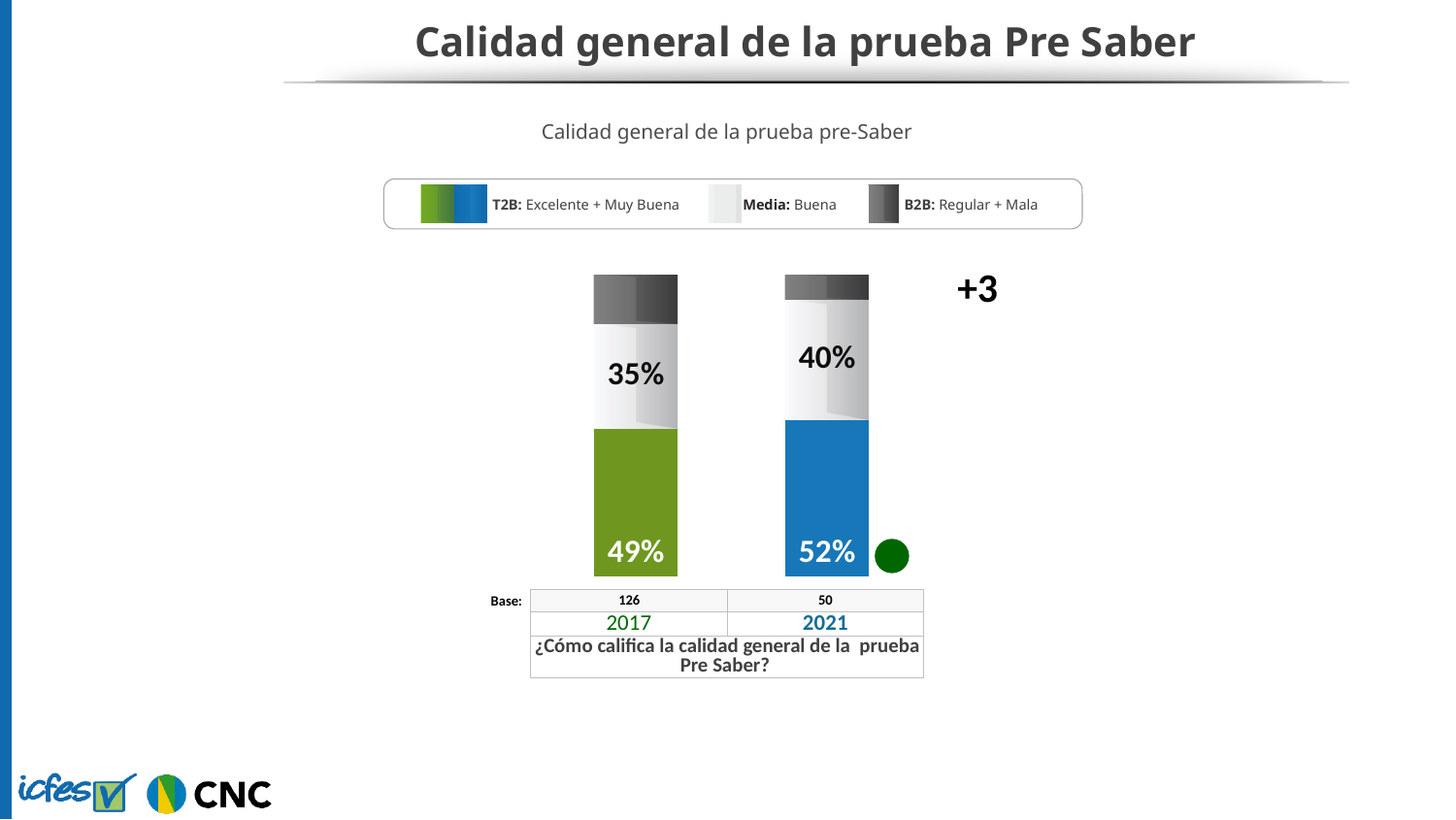
What is the T2B (Excelente + Muy Buena) value for 2017? 49% What is the Media (Buena) value for 2021? 40% Does the T2B value rise or fall from 2017 to 2021? rise What is the base (number of respondents) shown for 2017? 126 What kind of chart is shown on the slide? stacked bar chart What is the Media (Buena) value for 2017? 35% What is the T2B (Excelente + Muy Buena) value for 2021? 52% Which year has the larger T2B value, 2017 or 2021? 2021 How many years (bars) are shown in the chart? 2 How many series does the legend list? 3 By how many percentage points did the Media (Buena) value change from 2017 to 2021? 5 percentage points By how many percentage points did the T2B value change from 2017 to 2021? 3 percentage points